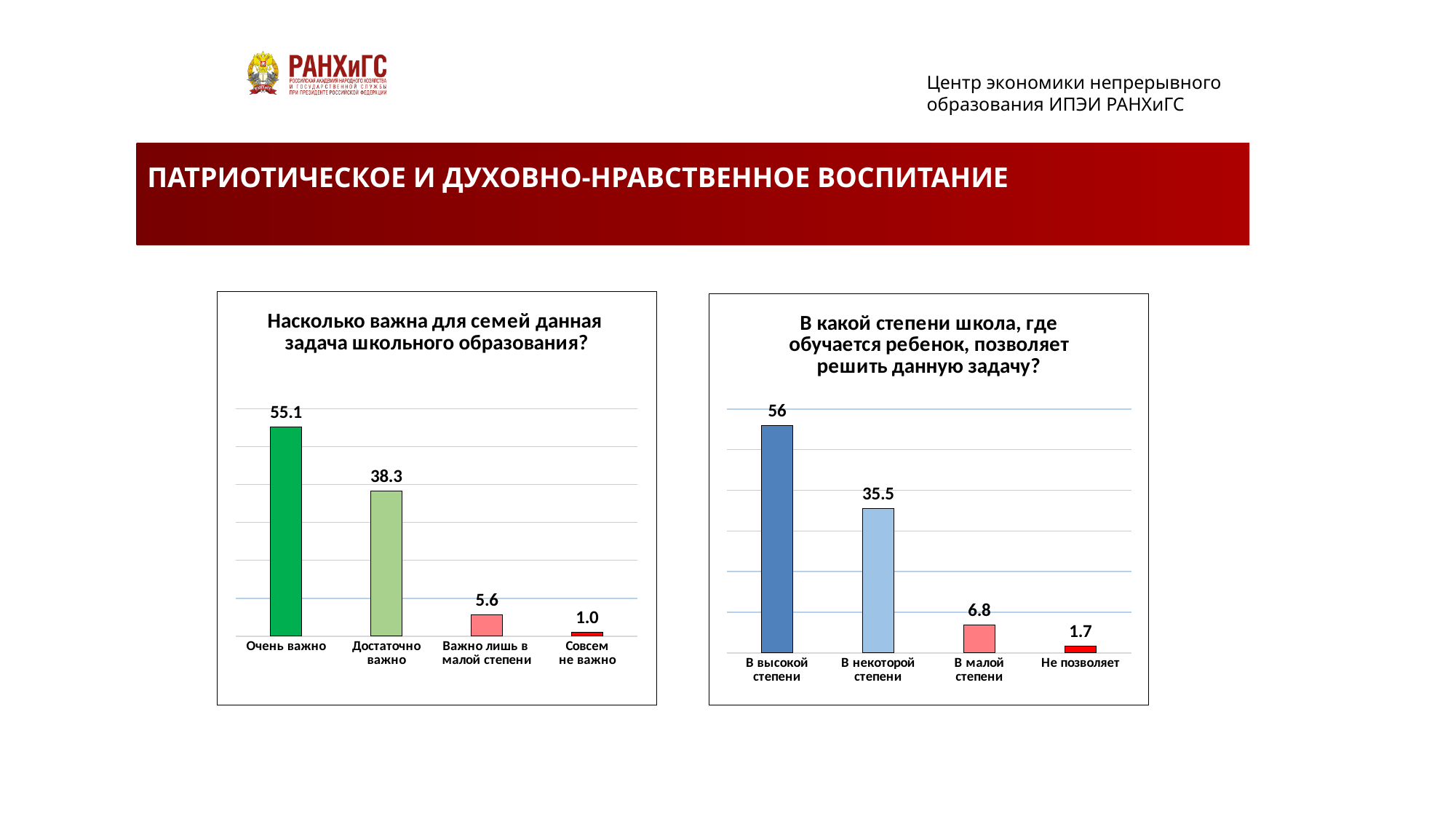
In the left chart 'Насколько важна для семей данная задача школьного образования?', what is the difference between 'Очень важно' and 'Достаточно важно'? 16.8 In the right chart 'В какой степени школа, где обучается ребенок, позволяет решить данную задачу?', which category has the lowest value? Не позволяет In the left chart 'Насколько важна для семей данная задача школьного образования?', how many categories are shown? 4 In the left chart 'Насколько важна для семей данная задача школьного образования?', what is the value for 'Совсем не важно'? 1.0 In the right chart 'В какой степени школа, где обучается ребенок, позволяет решить данную задачу?', which is larger: 'В малой степени' or 'Не позволяет'? В малой степени In the right chart 'В какой степени школа, где обучается ребенок, позволяет решить данную задачу?', what is the value for 'В некоторой степени'? 35.5 What type of chart is the right chart 'В какой степени школа, где обучается ребенок, позволяет решить данную задачу?'? Bar chart In the left chart 'Насколько важна для семей данная задача школьного образования?', do the values rise or fall from left to right? Fall In the right chart 'В какой степени школа, где обучается ребенок, позволяет решить данную задачу?', what is the value for 'Не позволяет'? 1.7 In the left chart 'Насколько важна для семей данная задача школьного образования?', which category has the highest value? Очень важно In the left chart 'Насколько важна для семей данная задача школьного образования?', what is the value for 'Очень важно'? 55.1 In the right chart 'В какой степени школа, где обучается ребенок, позволяет решить данную задачу?', what is the difference between 'В высокой степени' and 'В малой степени'? 49.2